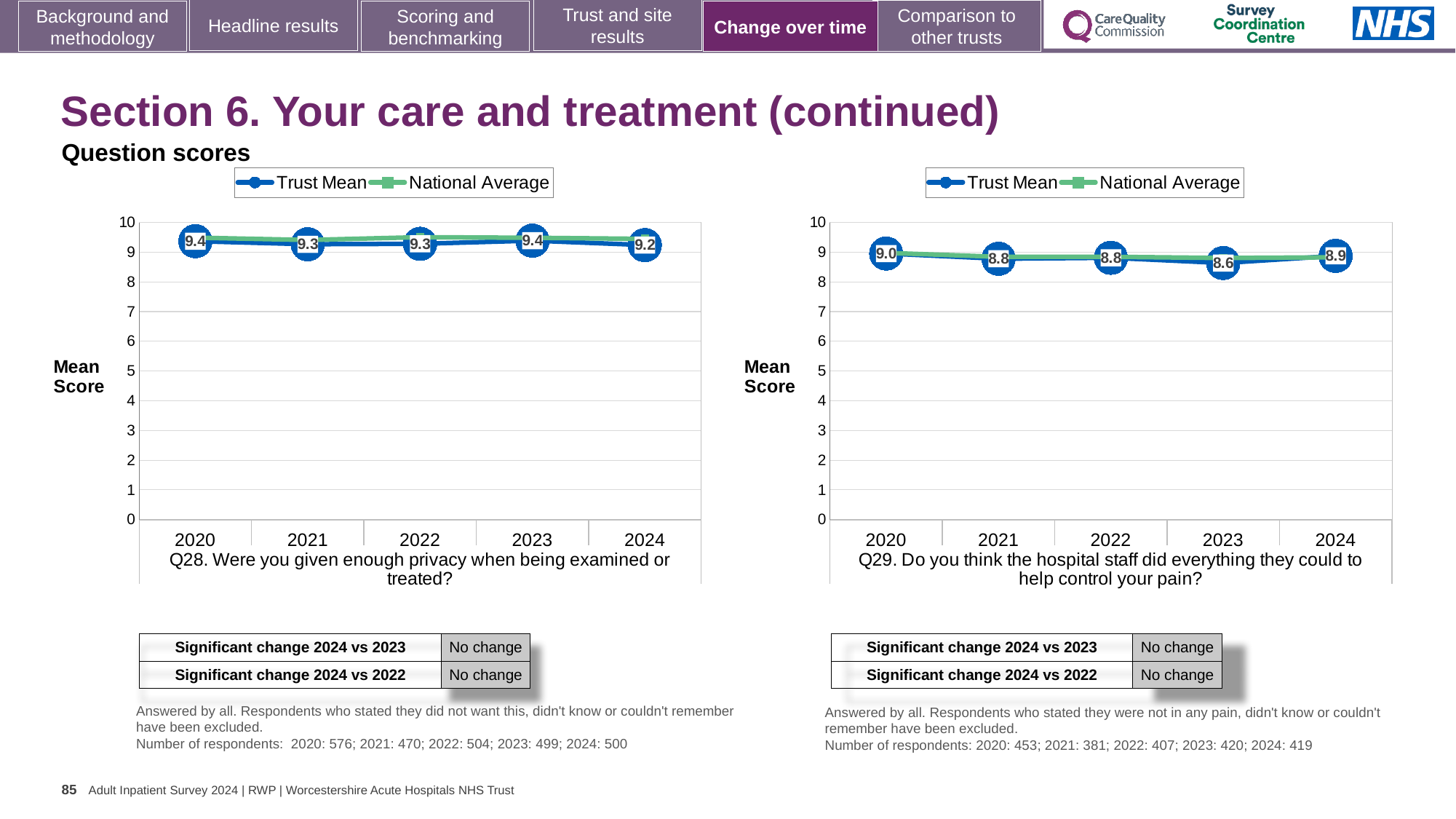
In the Q29 chart (right), what is the Trust Mean score for 2020? 9.0 What type of chart is used for Q28 (left)? Line chart In the Q28 chart (left), which year has the lowest Trust Mean score? 2024 In the Q29 chart (right), which year has the lowest Trust Mean score? 2023 In the Q28 chart (left), what is the Trust Mean score for 2024? 9.2 In the Q29 chart (right), what is the Trust Mean score for 2023? 8.6 How many years are plotted on the x axis of the Q28 chart (left)? 5 In the Q29 chart (right), is the Trust Mean value for 2024 greater or less than 8? greater In the Q28 chart (left), is the Trust Mean score for 2023 larger or smaller than the Trust Mean score for 2024? larger In the Q28 chart (left), what is the Trust Mean score for 2020? 9.4 In the Q29 chart (right), what is the difference between the Trust Mean scores for 2020 and 2023? 0.4 How many series does the legend of the Q29 chart (right) list? 2